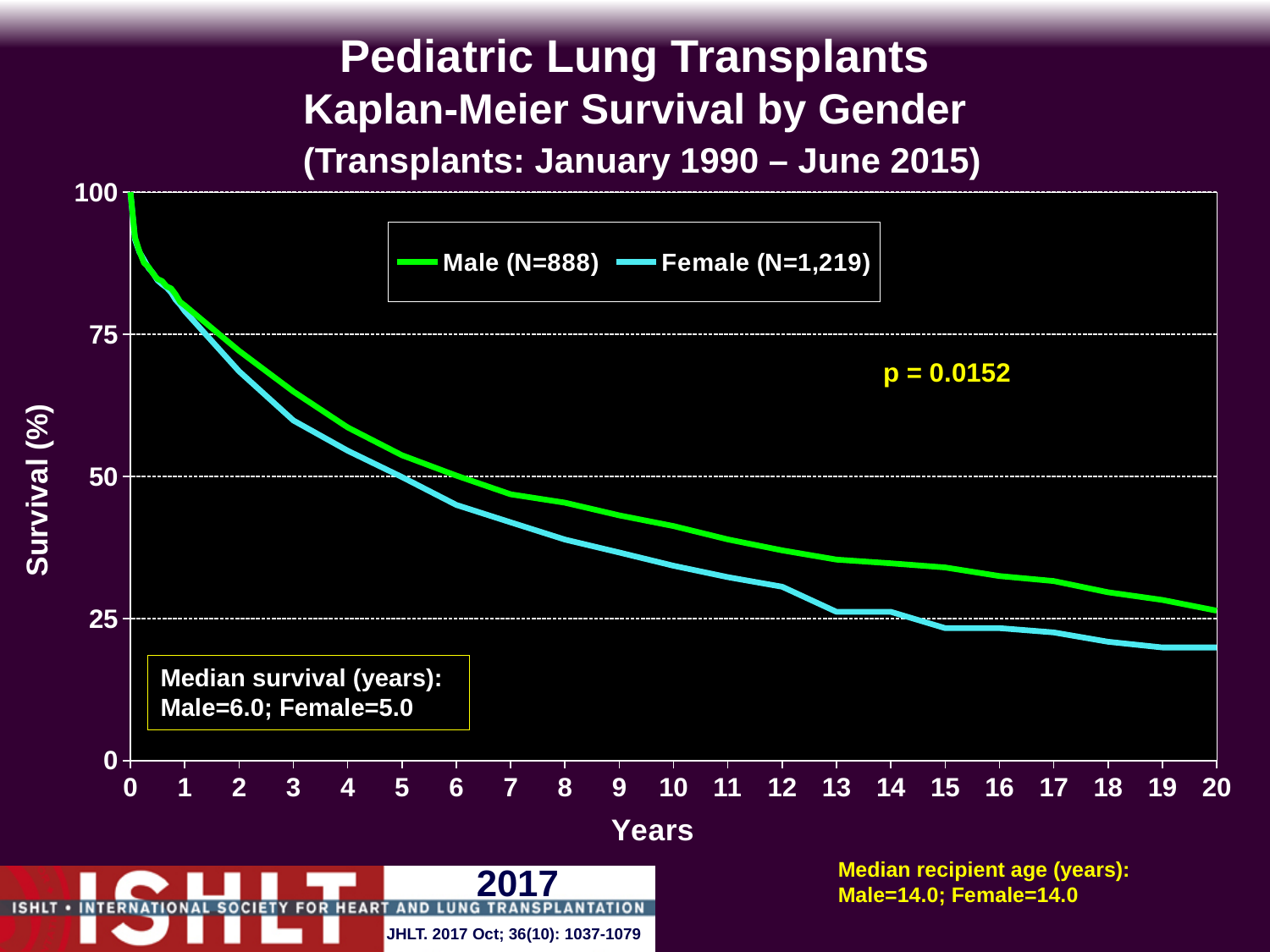
Is the Male survival value at 10 years greater or less than 25? greater Do the survival curves rise or fall as years increase? fall Is the Female survival value at 3 years greater or less than 50? greater At 10 years, which curve shows higher survival, Male or Female? Male How many series does the legend list? 2 What is the median survival in years for Male recipients? 6.0 Is the Female survival value at 20 years greater or less than 25? less What kind of chart is shown on the slide? line chart What is the difference in median survival (years) between Male and Female recipients? 1.0 Which group has the higher median survival, Male or Female? Male What p-value is printed on the chart? p = 0.0152 What is the median survival in years for Female recipients? 5.0